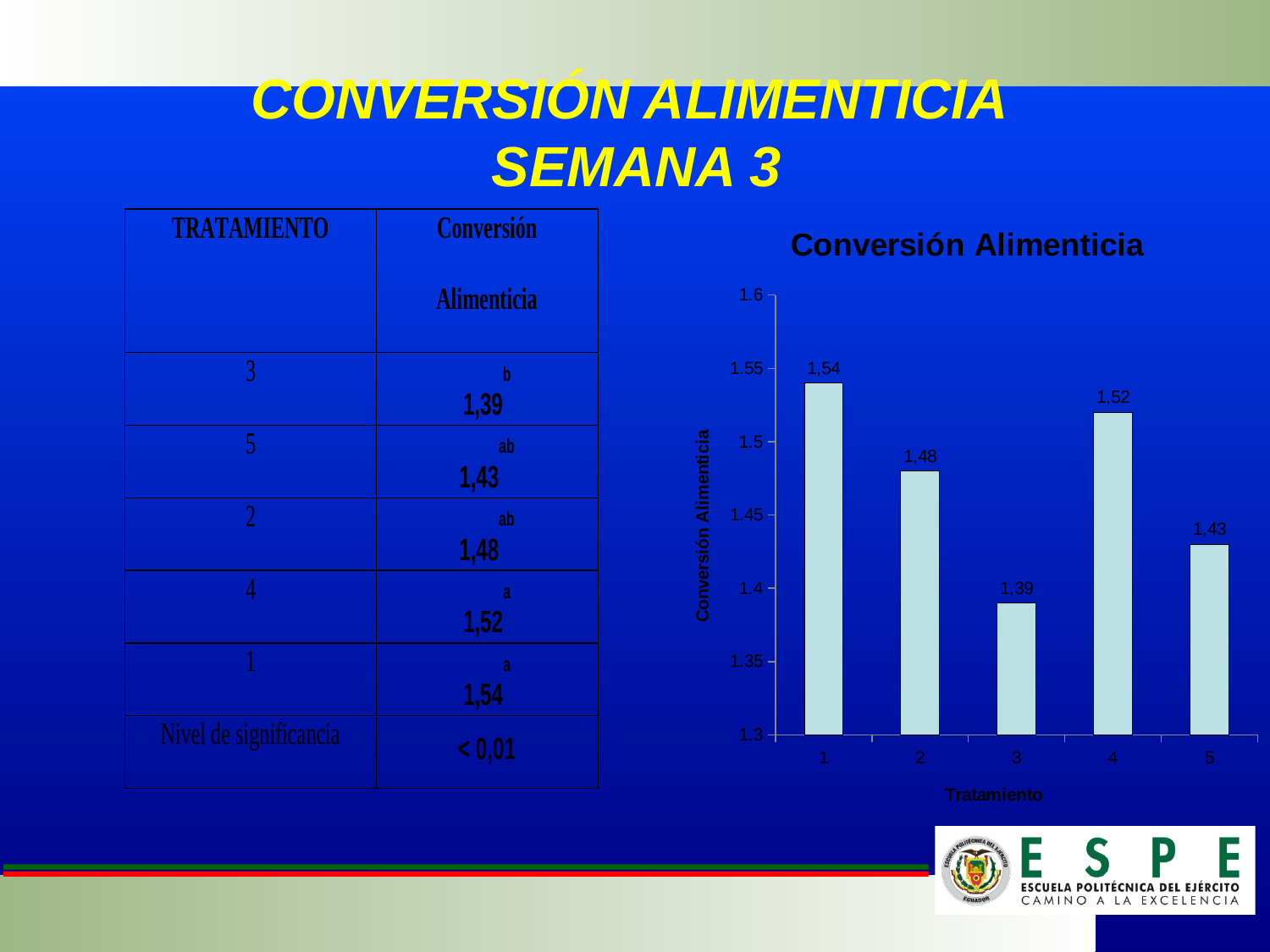
Which has a larger value in the chart, Tratamiento 2 or Tratamiento 4? Tratamiento 4 How many Tratamiento categories are shown in the chart? 5 What is the value for Tratamiento 5 in the Conversión Alimenticia chart? 1,43 What is the label of the x axis of the chart? Tratamiento What kind of chart is shown on the slide? bar chart What is the value for Tratamiento 1 in the Conversión Alimenticia chart? 1,54 What is the value for Tratamiento 3 in the Conversión Alimenticia chart? 1,39 Which Tratamiento has the highest Conversión Alimenticia in the chart? 1 Which Tratamiento has the lowest Conversión Alimenticia in the chart? 3 What is the title of the chart on the slide? Conversión Alimenticia Is the value for Tratamiento 5 in the chart greater or less than 1.45? less What is the difference between the values for Tratamiento 1 and Tratamiento 3 in the chart? 0,15